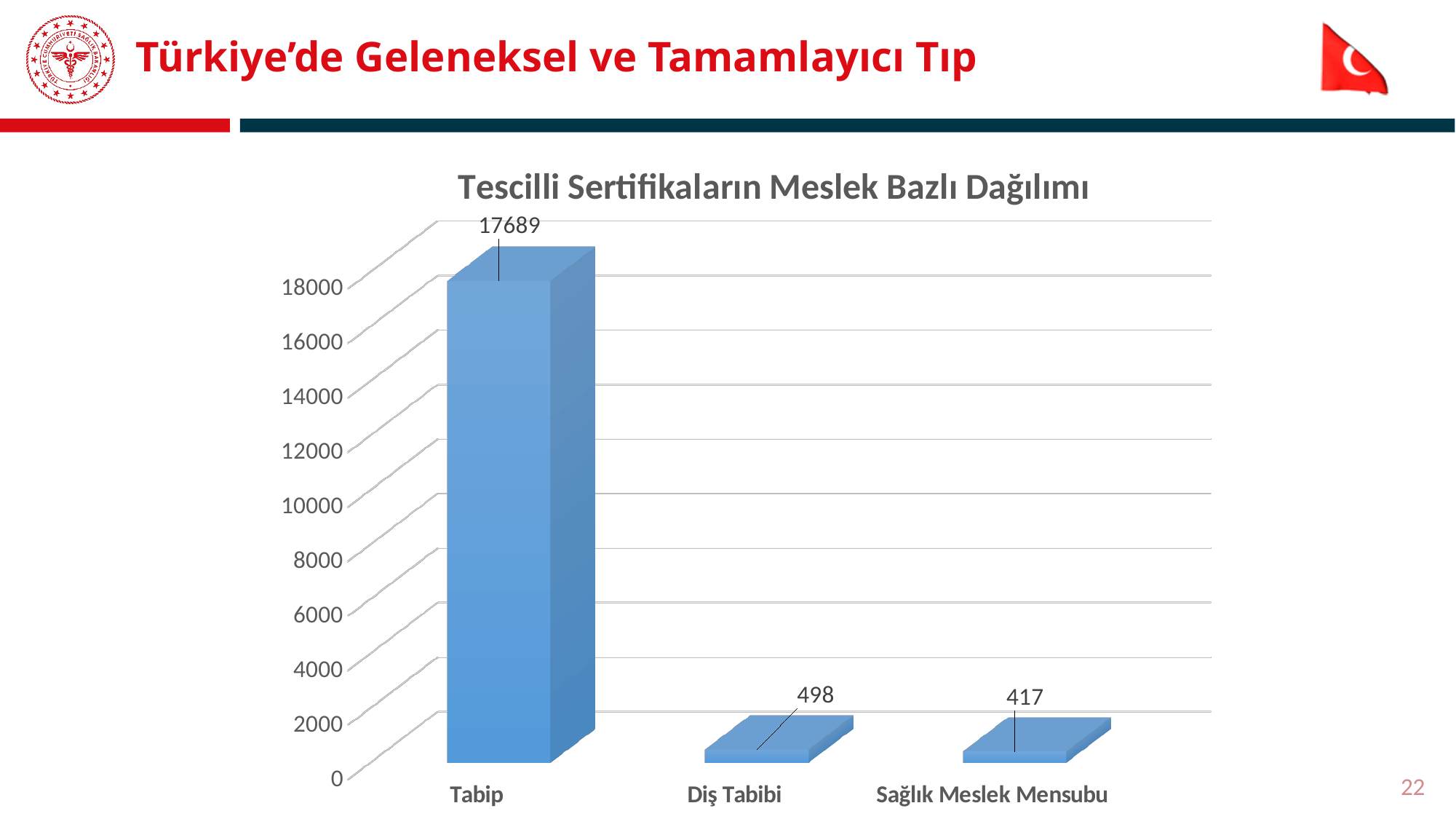
Which category has the lowest value? Sağlık Meslek Mensubu What is the value for Tabip? 17689 Which is larger, the value for Diş Tabibi or the value for Sağlık Meslek Mensubu? Diş Tabibi Which category has the highest value? Tabip What is the difference between the values for Tabip and Diş Tabibi? 17191 What is the difference between the values for Diş Tabibi and Sağlık Meslek Mensubu? 81 Is the value for Tabip greater or less than 16000? greater What kind of chart is shown on the slide? bar chart What is the value for Sağlık Meslek Mensubu? 417 What is the value for Diş Tabibi? 498 How many categories are shown on the x axis? 3 What is the title of the chart? Tescilli Sertifikaların Meslek Bazlı Dağılımı